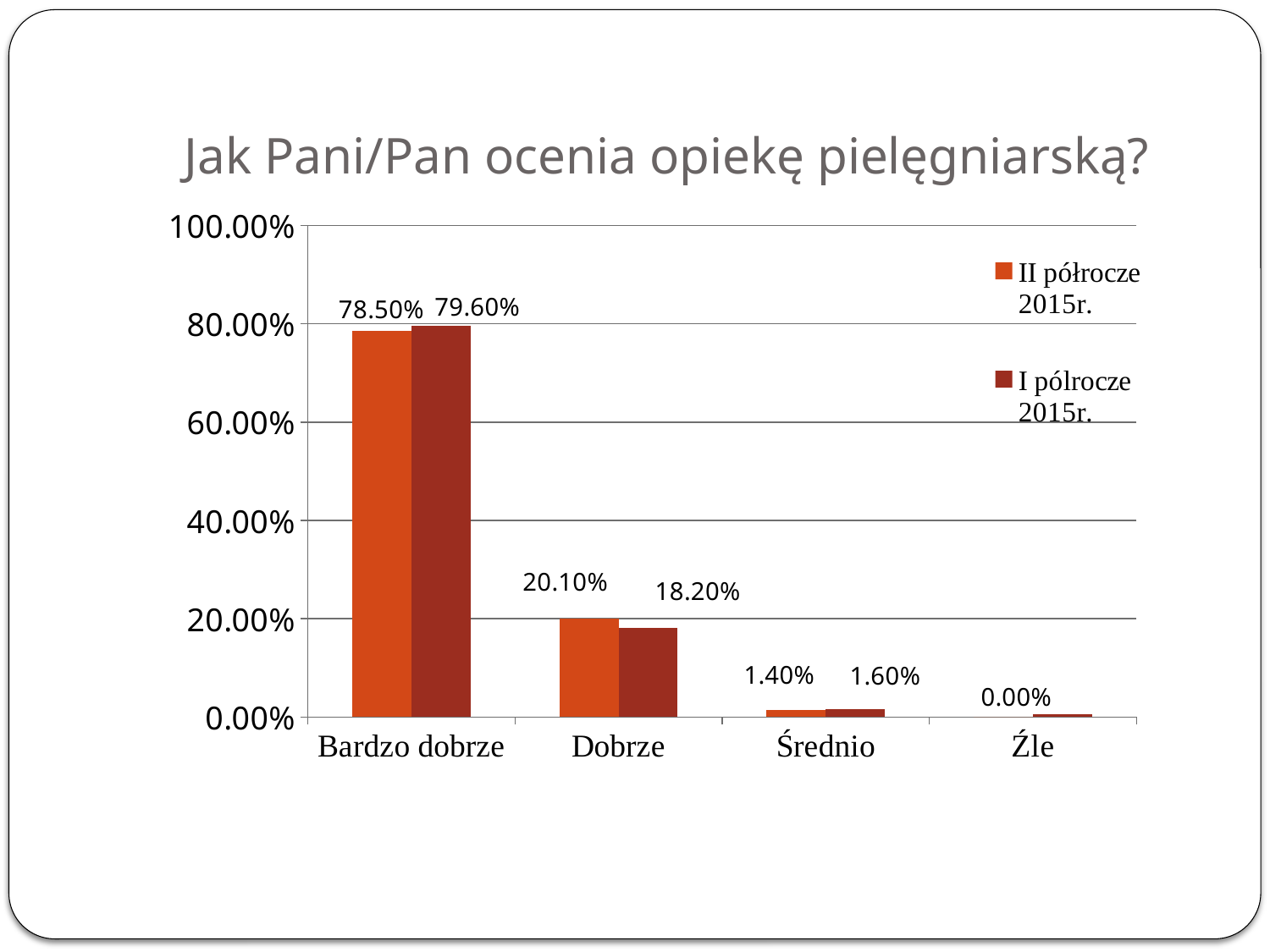
What type of chart is shown on the slide? bar chart What is the value for Bardzo dobrze in the II półrocze 2015r. series? 78.50% Is the value for Dobrze in the I półrocze 2015r. series greater or less than 20.00%? less What is the value for Średnio in the I półrocze 2015r. series? 1.60% Which category has the highest value in the II półrocze 2015r. series? Bardzo dobrze What is the value for Dobrze in the II półrocze 2015r. series? 20.10% What is the value for Bardzo dobrze in the I półrocze 2015r. series? 79.60% How many categories are shown on the x axis? 4 Which category has the lowest value in the II półrocze 2015r. series? Źle How many series does the legend list? 2 What is the difference between the I półrocze 2015r. and II półrocze 2015r. values for Dobrze? 1.90% For Bardzo dobrze, which series has the larger value: II półrocze 2015r. or I półrocze 2015r.? I półrocze 2015r.